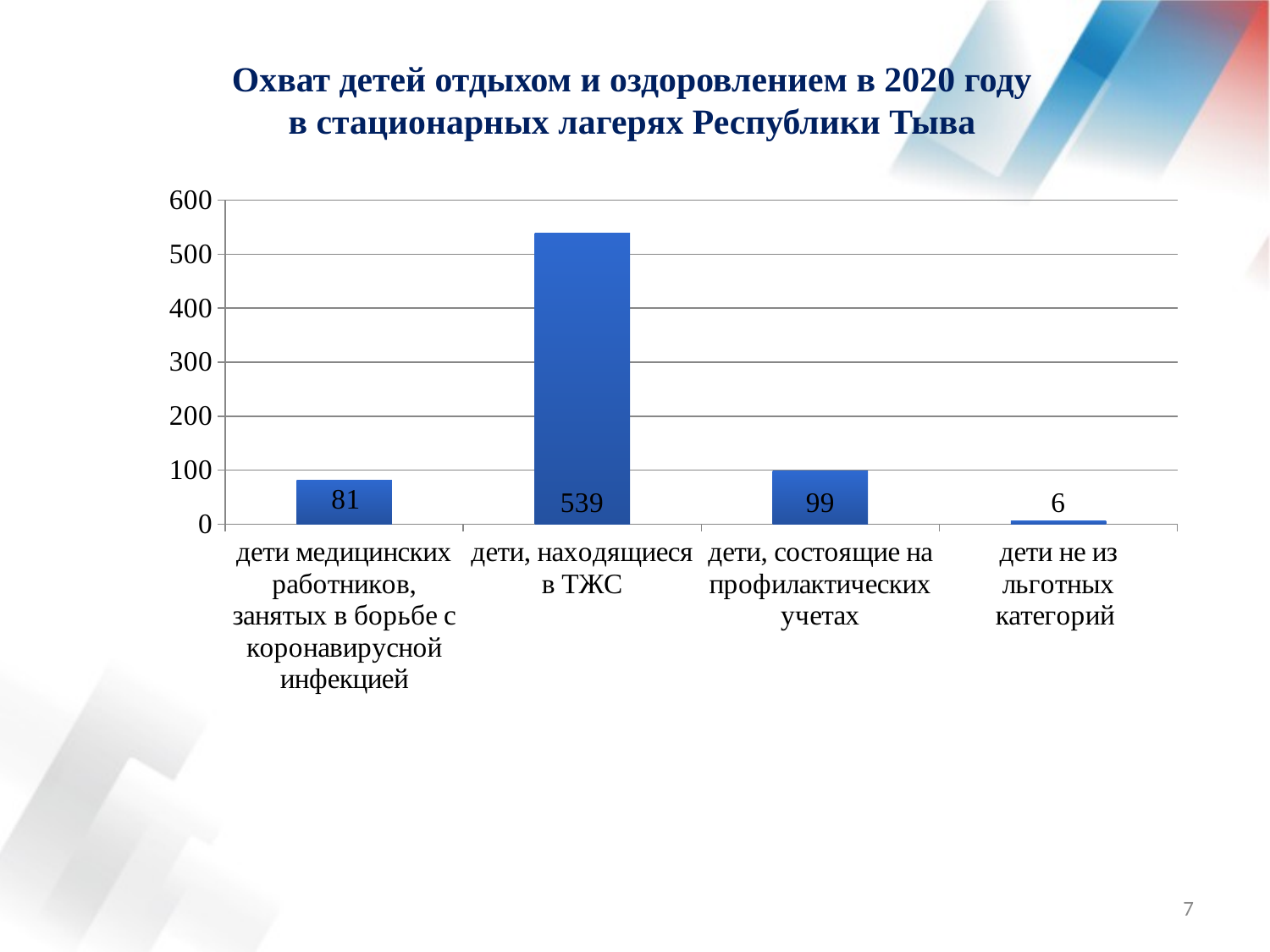
Is the value for дети, находящиеся в ТЖС greater or less than 500? greater How many categories are shown in the chart? 4 Which is larger: the value for дети, состоящие на профилактических учетах or the value for дети медицинских работников, занятых в борьбе с коронавирусной инфекцией? дети, состоящие на профилактических учетах What is the difference between the values for дети, находящиеся в ТЖС and дети, состоящие на профилактических учетах? 440 Which category has the lowest value? дети не из льготных категорий What kind of chart is shown on the slide? bar chart What is the value for дети не из льготных категорий? 6 What is the value for дети, находящиеся в ТЖС? 539 What is the value for дети, состоящие на профилактических учетах? 99 What is the difference between the values for дети, состоящие на профилактических учетах and дети медицинских работников, занятых в борьбе с коронавирусной инфекцией? 18 What is the value for дети медицинских работников, занятых в борьбе с коронавирусной инфекцией? 81 Which category has the highest value? дети, находящиеся в ТЖС